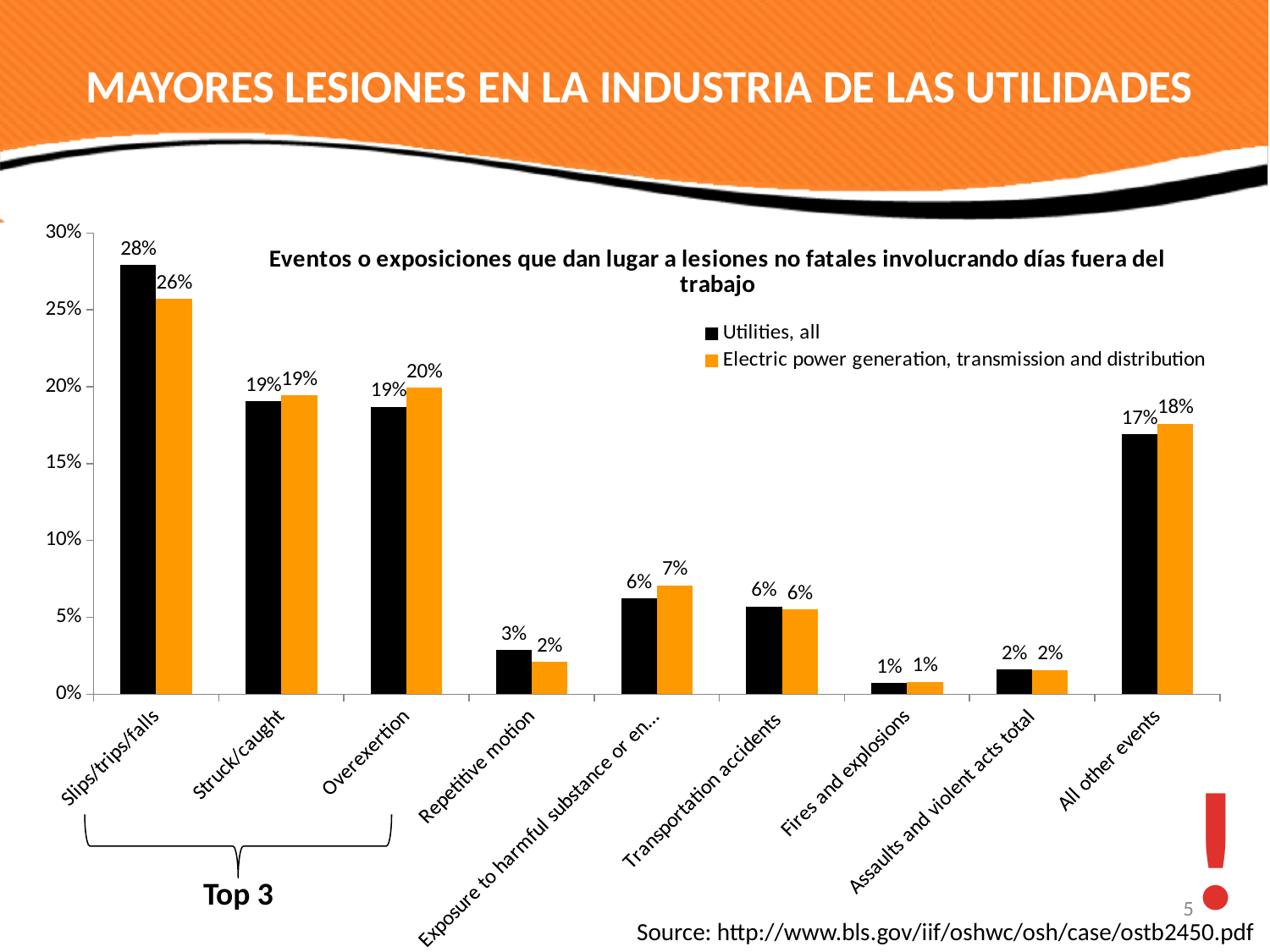
What kind of chart is shown on the slide? Bar chart Which category has the highest value in the Utilities, all series? Slips/trips/falls What is the value for Slips/trips/falls in the Electric power generation, transmission and distribution series? 26% What is the value for All other events in the Utilities, all series? 17% What is the value for Slips/trips/falls in the Utilities, all series? 28% For Repetitive motion, which series has the larger value: Utilities, all or Electric power generation, transmission and distribution? Utilities, all Which category has the lowest value in the Electric power generation, transmission and distribution series? Fires and explosions What is the value for Overexertion in the Electric power generation, transmission and distribution series? 20% How many categories are shown on the x axis of the chart? 9 Is the value for Transportation accidents in the Utilities, all series greater or less than 10%? less What is the difference between the Utilities, all value and the Electric power generation, transmission and distribution value for Slips/trips/falls? 2% How many series does the chart's legend list? 2